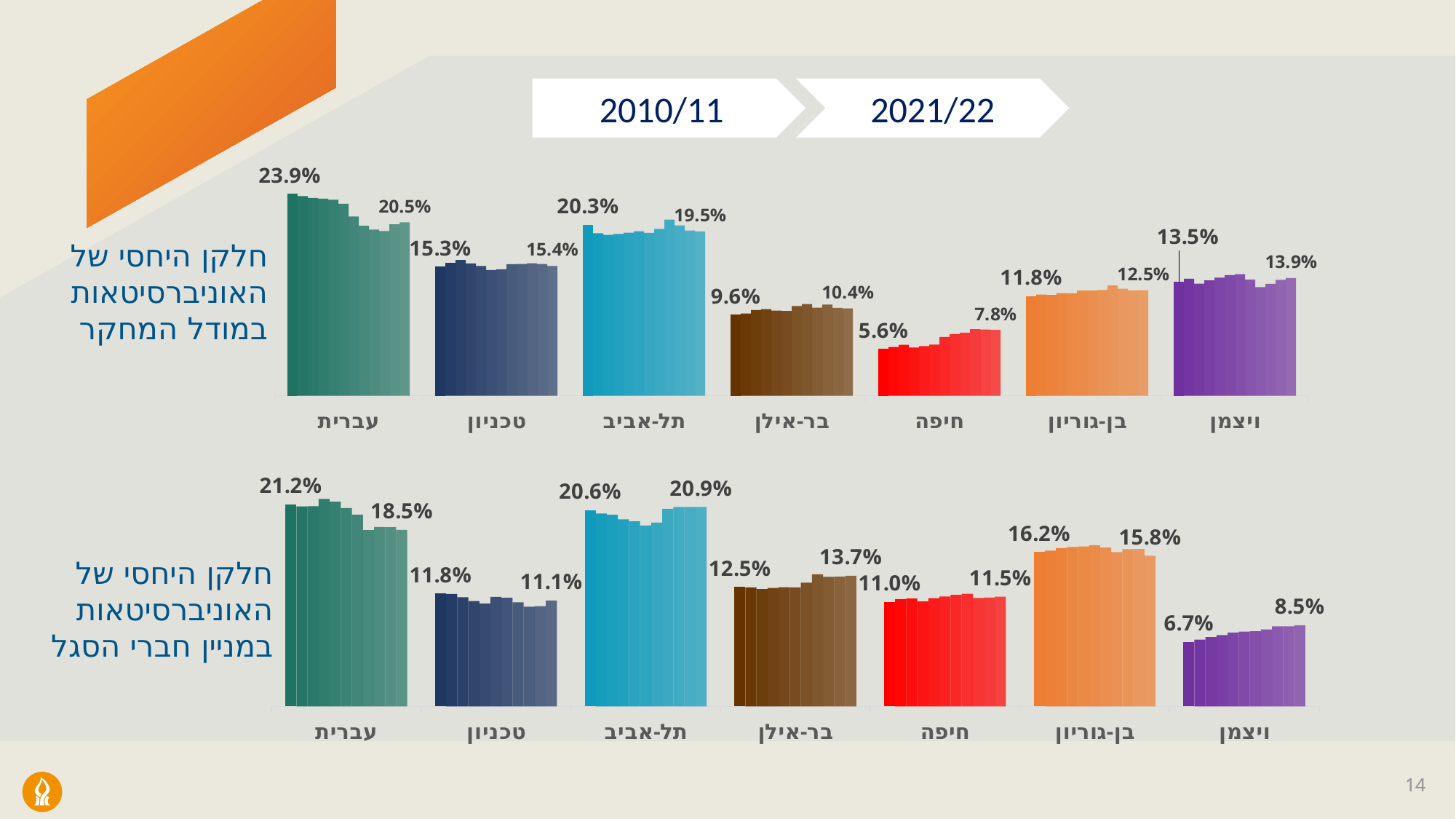
In the top chart, what is the difference between the 2010/11 and 2021/22 values for עברית (Hebrew University)? 3.4% In the top chart, which university has the lowest 2010/11 value? חיפה (Haifa) How many universities are shown in the bottom chart? 7 In the bottom chart, what is the 2010/11 value for ויצמן (Weizmann)? 6.7% Which two academic years are compared in the charts on this slide? 2010/11 and 2021/22 In the top chart, which is larger for בן-גוריון (Ben-Gurion): the 2010/11 value or the 2021/22 value? 2021/22 (12.5%) In the bottom chart, what is the difference between the 2021/22 and 2010/11 values for ויצמן (Weizmann)? 1.8% In the top chart (חלקן היחסי של האוניברסיטאות במודל המחקר), what is the 2010/11 value for עברית (Hebrew University)? 23.9% In the top chart, what is the 2021/22 value for חיפה (Haifa)? 7.8% In the bottom chart, which university has the lowest 2021/22 value? ויצמן (Weizmann) In the top chart, which university has the highest 2021/22 value? עברית (Hebrew University) In the bottom chart (חלקן היחסי של האוניברסיטאות במניין חברי הסגל), what is the 2021/22 value for תל-אביב (Tel Aviv)? 20.9%